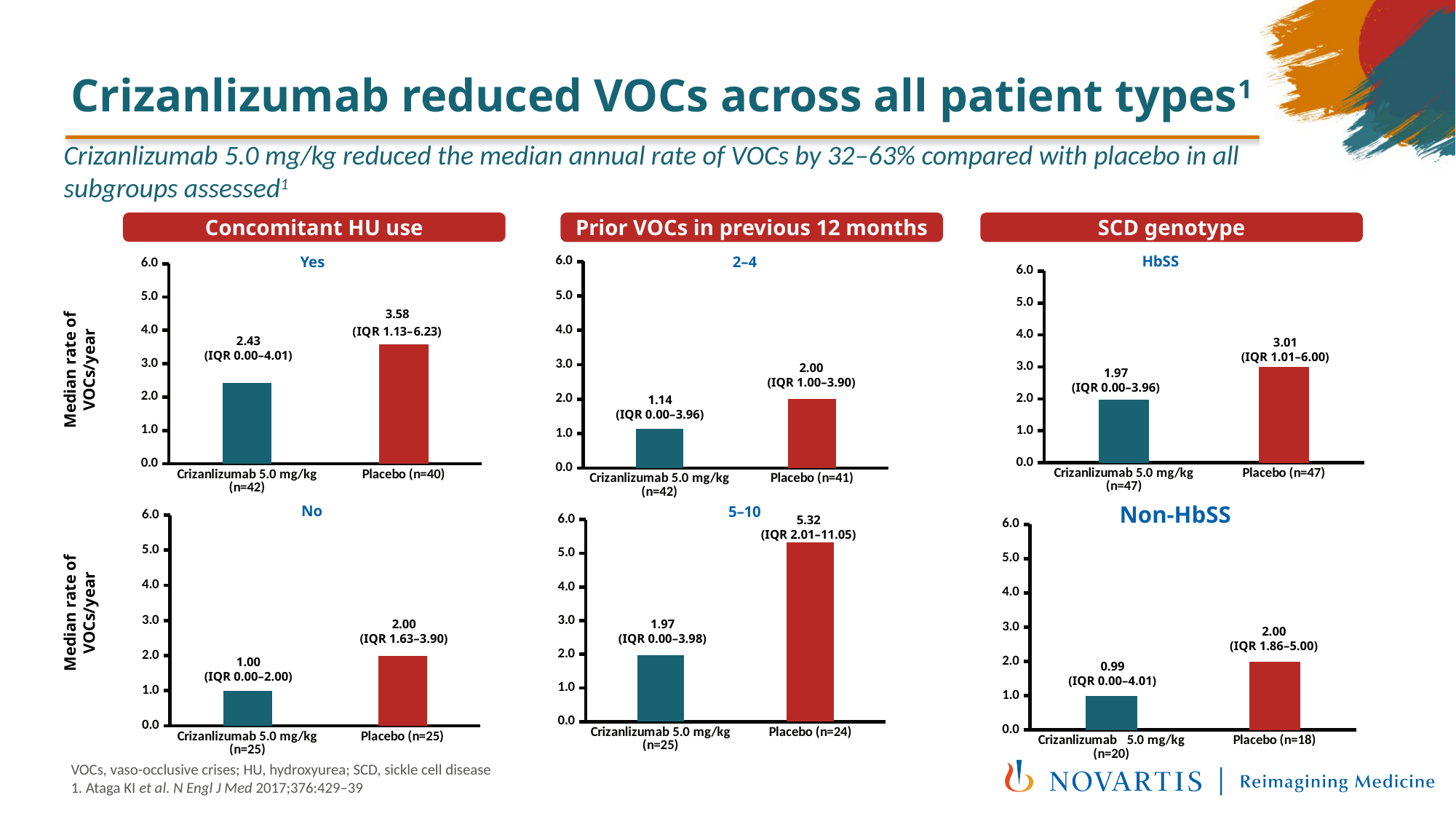
What is the y-axis label on the charts in the 'Concomitant HU use' column? Median rate of VOCs/year In the 'Prior VOCs in previous 12 months – 5–10' chart, is the value for Placebo (n=24) greater or less than 5.0? greater In the 'Concomitant HU use – Yes' chart, which bar is higher, Crizanlizumab 5.0 mg/kg or Placebo? Placebo In the 'SCD genotype – HbSS' chart, which bar is the lowest? Crizanlizumab 5.0 mg/kg (n=47) In the 'SCD genotype – Non-HbSS' chart, what is the median rate of VOCs/year for Crizanlizumab 5.0 mg/kg (n=20)? 0.99 In the 'Concomitant HU use – Yes' chart, what is the median rate of VOCs/year for Placebo (n=40)? 3.58 In the 'Prior VOCs in previous 12 months – 2–4' chart, what is the difference between the Placebo and Crizanlizumab median rates of VOCs/year? 0.86 In the 'Concomitant HU use – No' chart, what is the median rate of VOCs/year for Crizanlizumab 5.0 mg/kg (n=25)? 1.00 In the 'SCD genotype – HbSS' chart, what is the difference between the Placebo and Crizanlizumab median rates of VOCs/year? 1.04 What type of chart is used in the 'SCD genotype – Non-HbSS' panel? Bar chart How many bars are shown in the 'Concomitant HU use – No' chart? 2 In the 'Prior VOCs in previous 12 months – 5–10' chart, what is the median rate of VOCs/year for Placebo (n=24)? 5.32